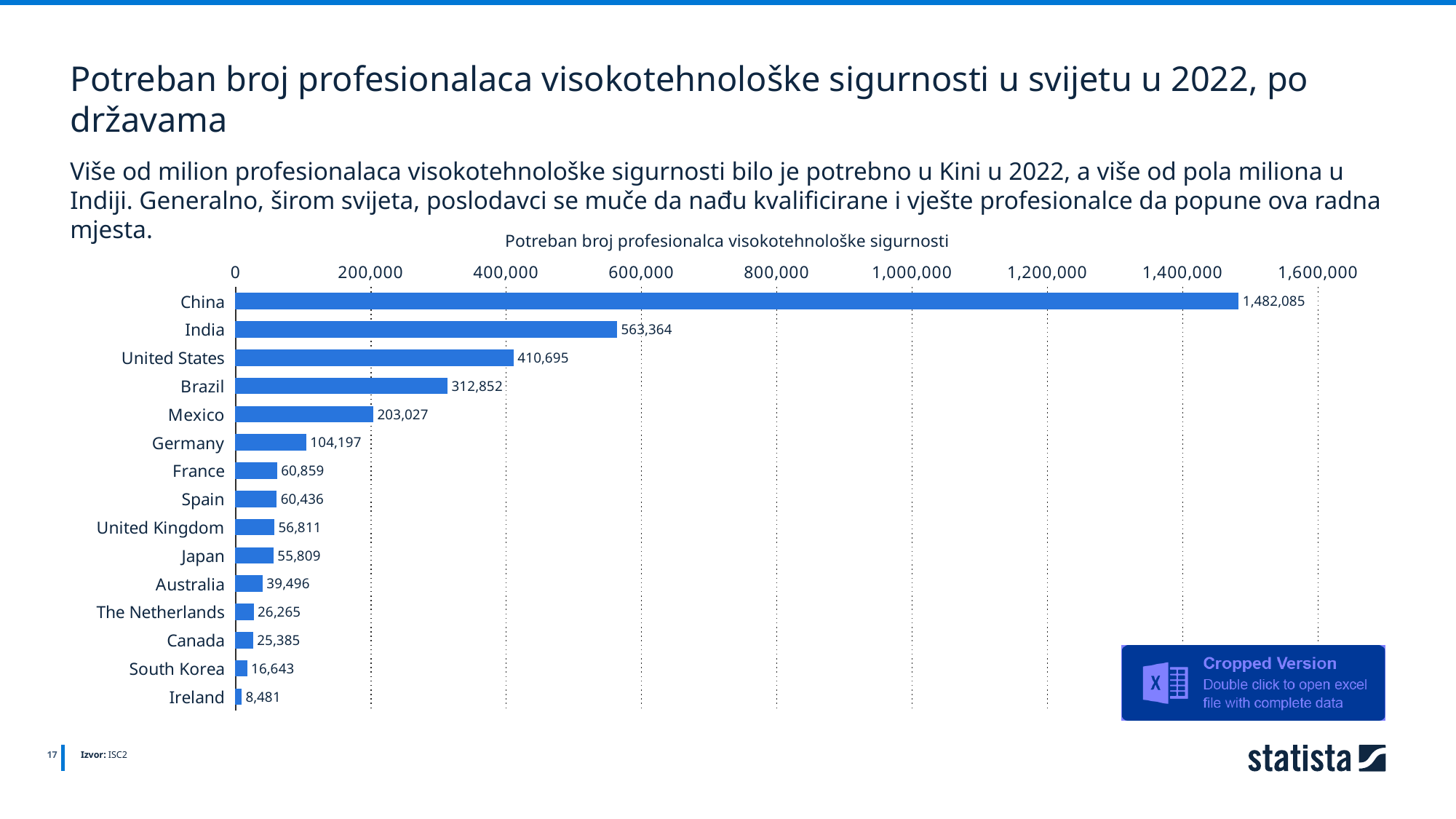
What kind of chart is shown on the slide? bar chart What is the difference between the values for Brazil and Mexico? 109,825 Which country has the highest value? China What is the value for China? 1,482,085 What is the value for The Netherlands? 26,265 What is the value for Japan? 55,809 What is the value for Brazil? 312,852 Which country has the lowest value? Ireland How many countries are shown in the chart? 15 Which has a larger value, Mexico or Germany? Mexico Is the value for China greater or less than 1,400,000? greater What is the difference between the values for India and the United States? 152,669